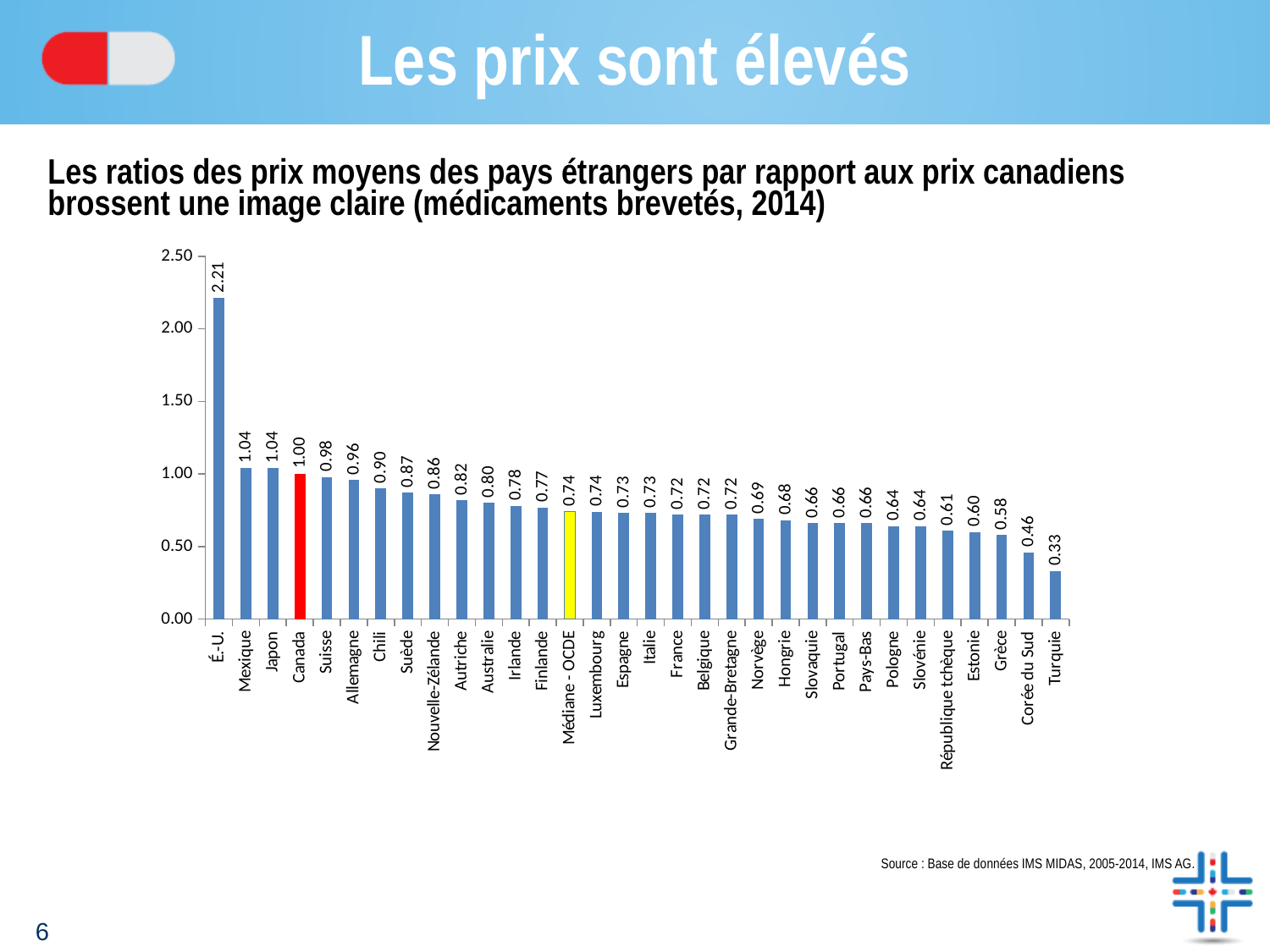
What is the value for Canada? 1.00 How many categories are shown on the x axis? 32 Which bar is coloured red? Canada Is the value for Corée du Sud greater or less than 0.50? less Which category has the lowest value? Turquie Which is larger, the value for Suisse or the value for Allemagne? Suisse What is the value for É.-U.? 2.21 What is the value for Turquie? 0.33 What is the value for Médiane - OCDE? 0.74 What is the difference between the values for É.-U. and Canada? 1.21 Which category has the highest value? É.-U. What kind of chart is shown on the slide? bar chart